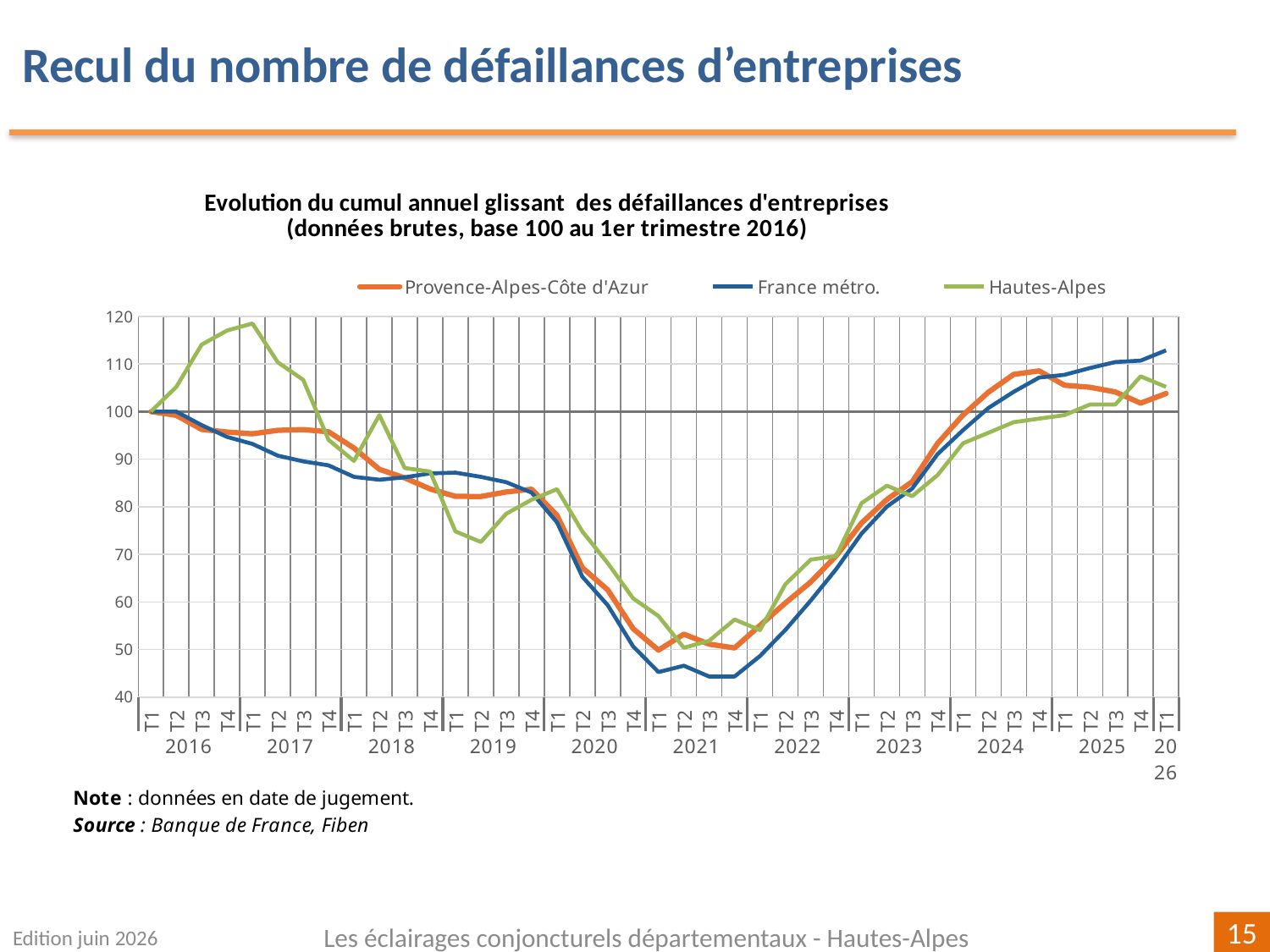
Is the value for Hautes-Alpes at T2 2019 greater or less than 80? less Which series is drawn in green in the legend? Hautes-Alpes At T1 2017, which is larger: Hautes-Alpes or France métro.? Hautes-Alpes Which series has the lowest value at T4 2021? France métro. Is the value for France métro. at T4 2021 greater or less than 50? less What is the value of each series at T1 2016, the base period? 100 How many series does the legend list? 3 What kind of chart is shown on the slide? line chart Does the France métro. series rise or fall from T1 2016 to T4 2021? fall Which series has the highest value at T1 2026? France métro. Is the value for France métro. at T1 2026 greater or less than 110? greater